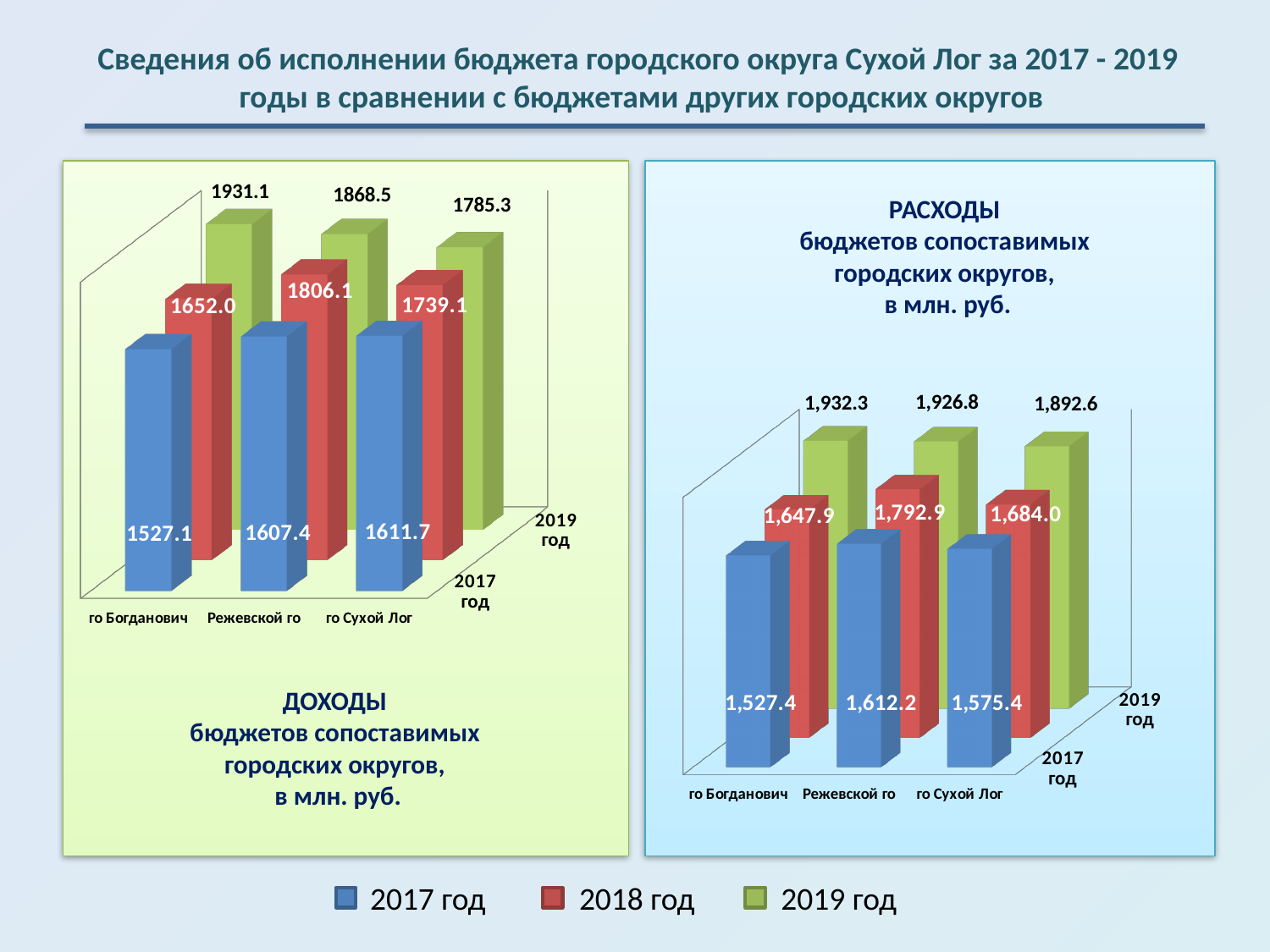
How many series does the legend at the bottom of the slide list? 3 How many city districts are shown on the РАСХОДЫ chart (right)? 3 On the ДОХОДЫ chart (left), what is the value for Режевской го in 2018 год? 1806.1 What kind of chart is the ДОХОДЫ chart (left)? Bar chart On the ДОХОДЫ chart (left), what is the value for го Сухой Лог in 2019 год? 1785.3 On the РАСХОДЫ chart (right), what is the value for го Сухой Лог in 2018 год? 1,684.0 On the РАСХОДЫ chart (right), which city district has the lowest value in 2017 год? го Богданович On the РАСХОДЫ chart (right), what is the difference between the 2018 год values for Режевской го and го Богданович? 145.0 On the ДОХОДЫ chart (left), which is larger for 2018 год: го Богданович or го Сухой Лог? го Сухой Лог On the ДОХОДЫ chart (left), what is the difference between the 2019 год and 2017 год values for го Сухой Лог? 173.6 On the ДОХОДЫ chart (left), which city district has the highest value in 2019 год? го Богданович On the РАСХОДЫ chart (right), what is the value for го Богданович in 2017 год? 1,527.4